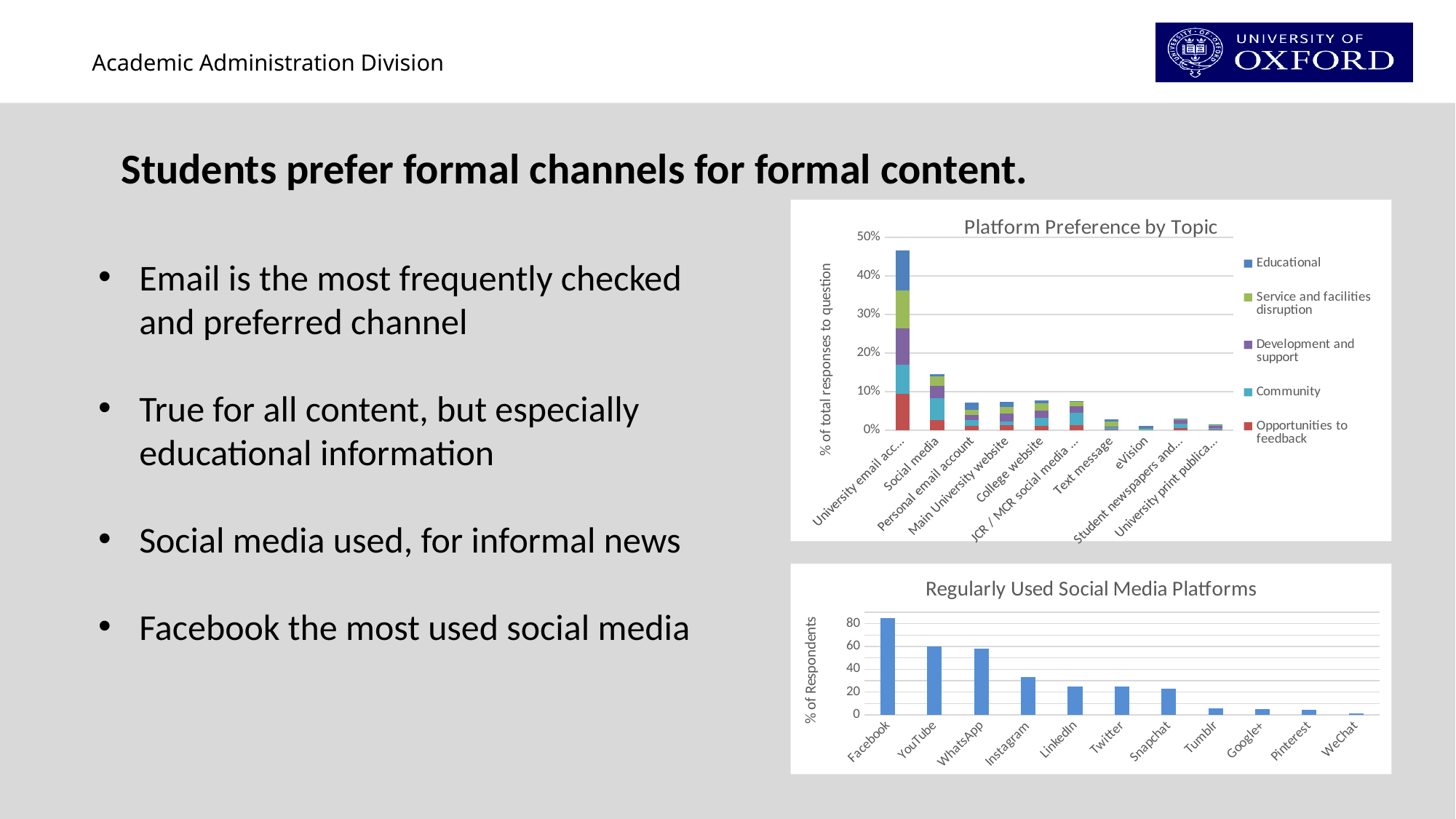
In the 'Regularly Used Social Media Platforms' chart, which platform has the highest value? Facebook In the 'Platform Preference by Topic' chart, is the total stacked value for Social media greater or less than 10%? greater How many series does the legend of the 'Platform Preference by Topic' chart list? 5 What kind of chart is the 'Regularly Used Social Media Platforms' chart? bar chart What is the y-axis label of the 'Regularly Used Social Media Platforms' chart? % of Respondents In the 'Regularly Used Social Media Platforms' chart, is the value for Facebook greater or less than 80? greater How many categories are shown on the x axis of the 'Platform Preference by Topic' chart? 10 In the 'Regularly Used Social Media Platforms' chart, which platform has the lowest value? WeChat In the 'Platform Preference by Topic' chart, which category has the tallest stacked bar? University email account How many platforms are shown on the x axis of the 'Regularly Used Social Media Platforms' chart? 11 In the 'Regularly Used Social Media Platforms' chart, which is larger, the value for Instagram or the value for LinkedIn? Instagram In the 'Regularly Used Social Media Platforms' chart, is the value for Tumblr greater or less than 20? less